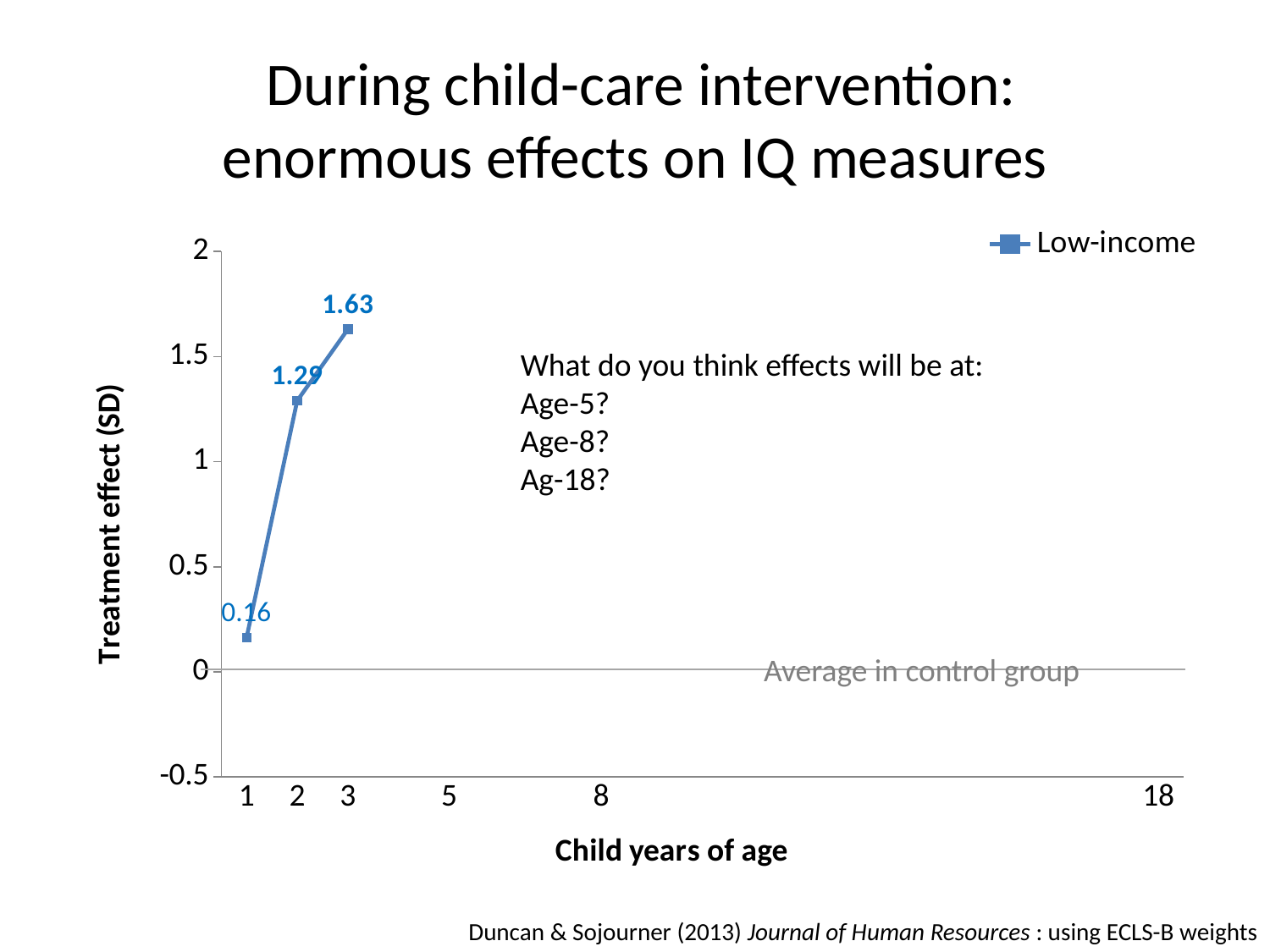
What kind of chart is shown on the slide? line chart What is the treatment effect for low-income children at age 2? 1.29 At which age is the plotted treatment effect lowest? 1 Is the treatment effect at age 2 greater or less than 1? greater What is the treatment effect for low-income children at age 1? 0.16 Which is larger, the treatment effect at age 2 or at age 3? age 3 What is the treatment effect for low-income children at age 3? 1.63 At which age is the plotted treatment effect highest? 3 How many data points are plotted on the line? 3 What is the difference between the treatment effect at age 2 and at age 1? 1.13 What is the difference between the treatment effect at age 3 and at age 1? 1.47 Does the treatment effect rise or fall from age 1 to age 3? rise